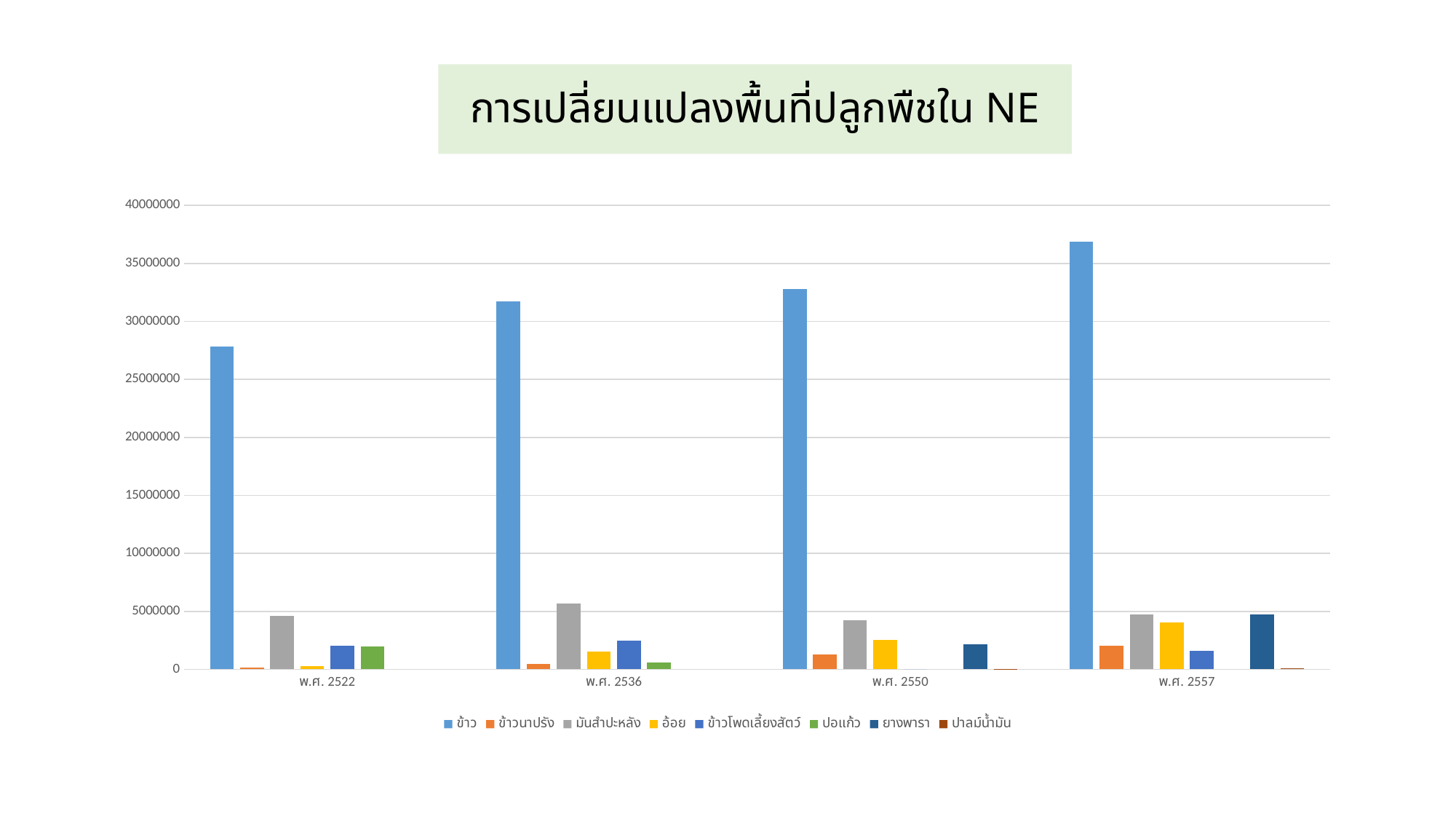
Is the value for ข้าว in พ.ศ. 2536 greater or less than 30000000? greater Is the value for ข้าว in พ.ศ. 2522 greater or less than 30000000? less In which year is the value for ข้าว the highest? พ.ศ. 2557 In which year is the value for ข้าว the lowest? พ.ศ. 2522 What is the title of the chart? การเปลี่ยนแปลงพื้นที่ปลูกพืชใน NE Which series is the tallest bar in every year? ข้าว How many year categories are shown on the x axis? 4 Does the value for ข้าว rise or fall from พ.ศ. 2522 to พ.ศ. 2557? rise What kind of chart is shown on the slide? bar chart How many series does the legend list? 8 Is the value for ข้าว in พ.ศ. 2557 greater or less than 35000000? greater Which is larger, the value for มันสำปะหลัง in พ.ศ. 2536 or in พ.ศ. 2550? พ.ศ. 2536